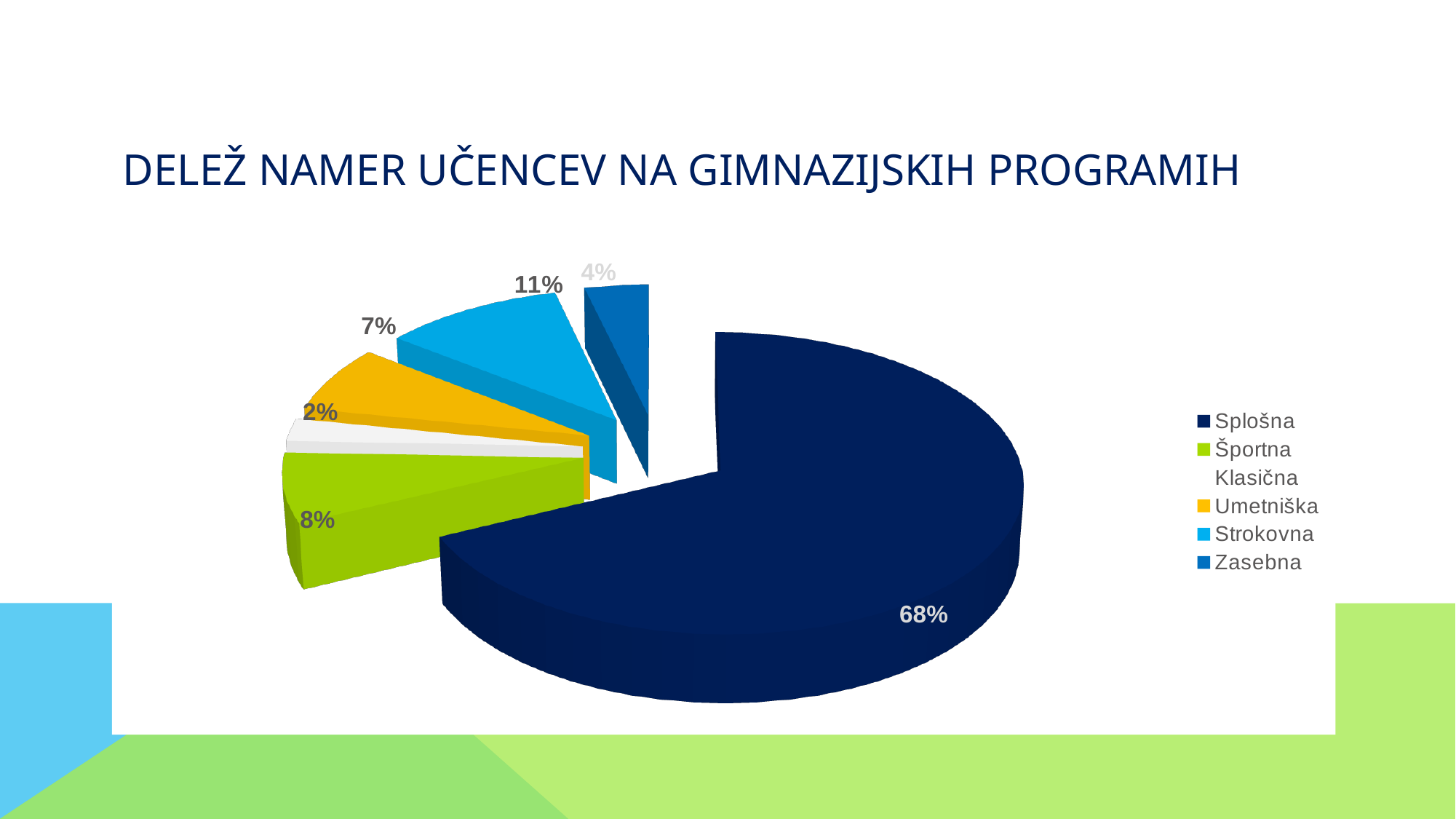
What share of the pie does Zasebna have? 4% How many categories does the legend list? 6 Which category has the largest slice of the pie? Splošna Which has a larger share, Športna or Zasebna? Športna What is the difference between the shares of Strokovna and Umetniška? 4% What share of the pie does Strokovna have? 11% Which category has the smallest slice of the pie? Klasična What share of the pie does Umetniška have? 7% What is the title of the chart? DELEŽ NAMER UČENCEV NA GIMNAZIJSKIH PROGRAMIH What kind of chart is shown on the slide? pie chart